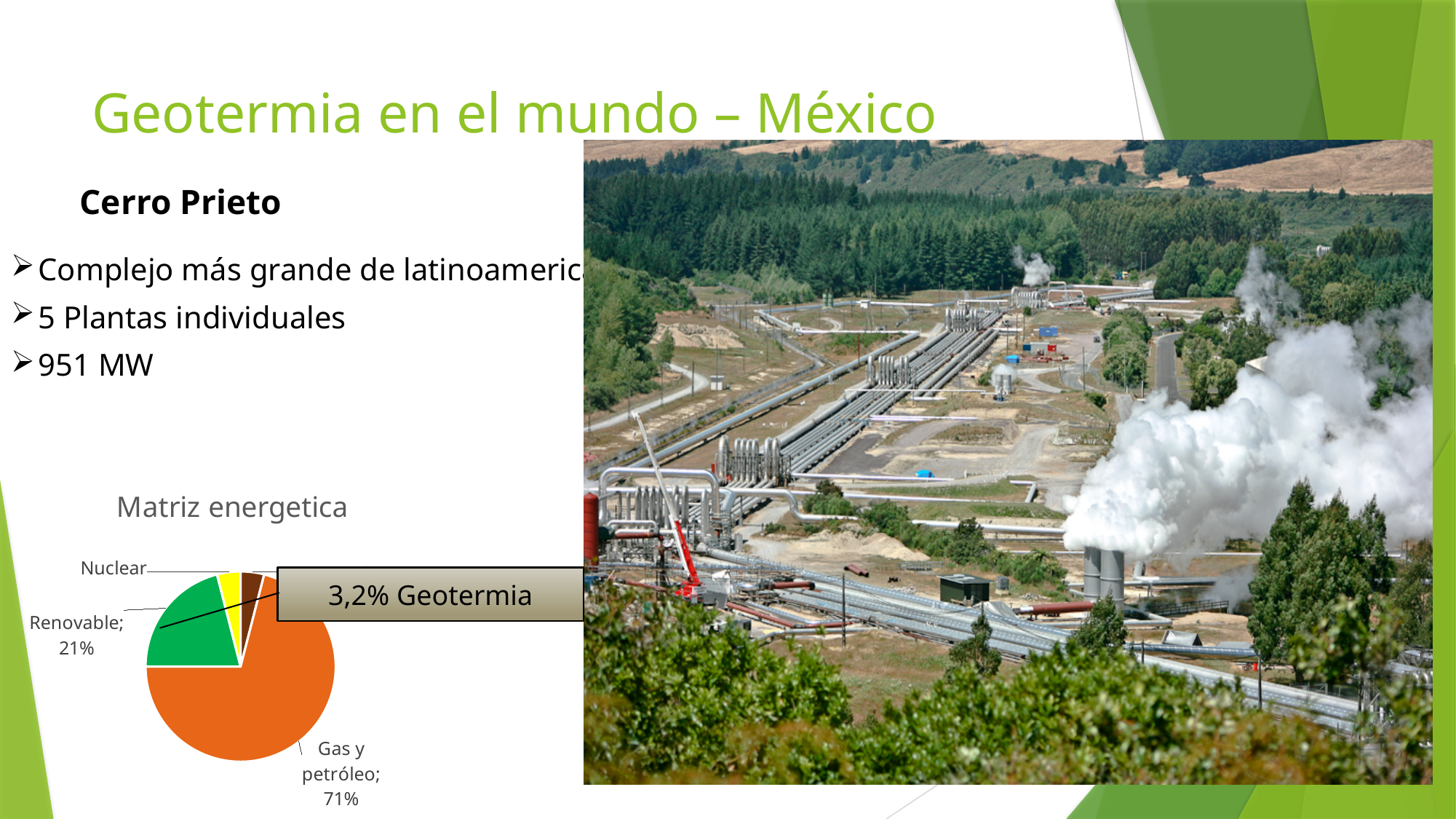
What is the title of the pie chart on the slide? Matriz energetica What does the callout box next to the pie chart say? 3,2% Geotermia How many slices does the "Matriz energetica" pie chart have? 4 What kind of chart is shown under the heading "Matriz energetica"? pie chart In the "Matriz energetica" pie chart, is the share for Gas y petróleo greater or less than 50%? greater In the "Matriz energetica" pie chart, how many percentage points larger is Gas y petróleo than Renovable? 50 percentage points In the "Matriz energetica" pie chart, is the share for Renovable greater or less than 50%? less Which category has the largest slice in the "Matriz energetica" pie chart? Gas y petróleo In the "Matriz energetica" pie chart, which is larger: Gas y petróleo or Renovable? Gas y petróleo In the "Matriz energetica" pie chart, what share is shown for Gas y petróleo? 71% In the "Matriz energetica" pie chart, what share is shown for Renovable? 21%